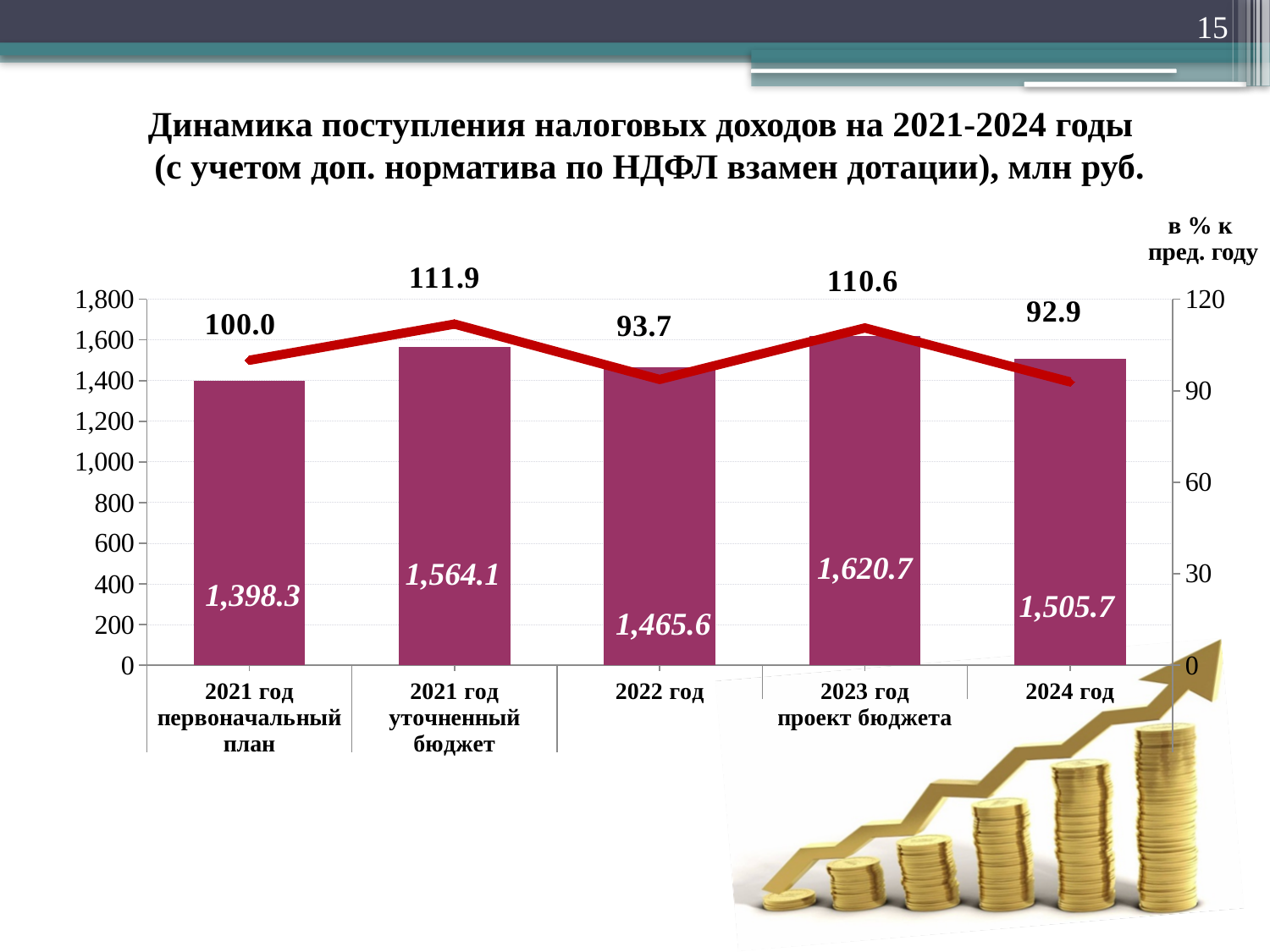
What is the difference between the tax revenue for 2023 год проект бюджета and 2024 год? 115.0 Which is larger: the tax revenue for 2021 год уточненный бюджет or for 2022 год? 2021 год уточненный бюджет Which category has the highest tax revenue bar? 2023 год проект бюджета How many categories are shown on the x axis? 5 What percentage to the previous year is shown for 2022 год? 93.7 What is the tax revenue value shown for 2021 год первоначальный план? 1,398.3 What percentage to the previous year is shown for 2021 год уточненный бюджет? 111.9 What kind of chart is shown on the slide? Combined bar and line chart What is the lowest percentage to the previous year shown on the line? 92.9 What is the tax revenue value (in mln rub) shown for 2023 год проект бюджета? 1,620.7 Is the tax revenue for 2024 год greater or less than 1,400? greater Which category has the lowest tax revenue bar? 2021 год первоначальный план